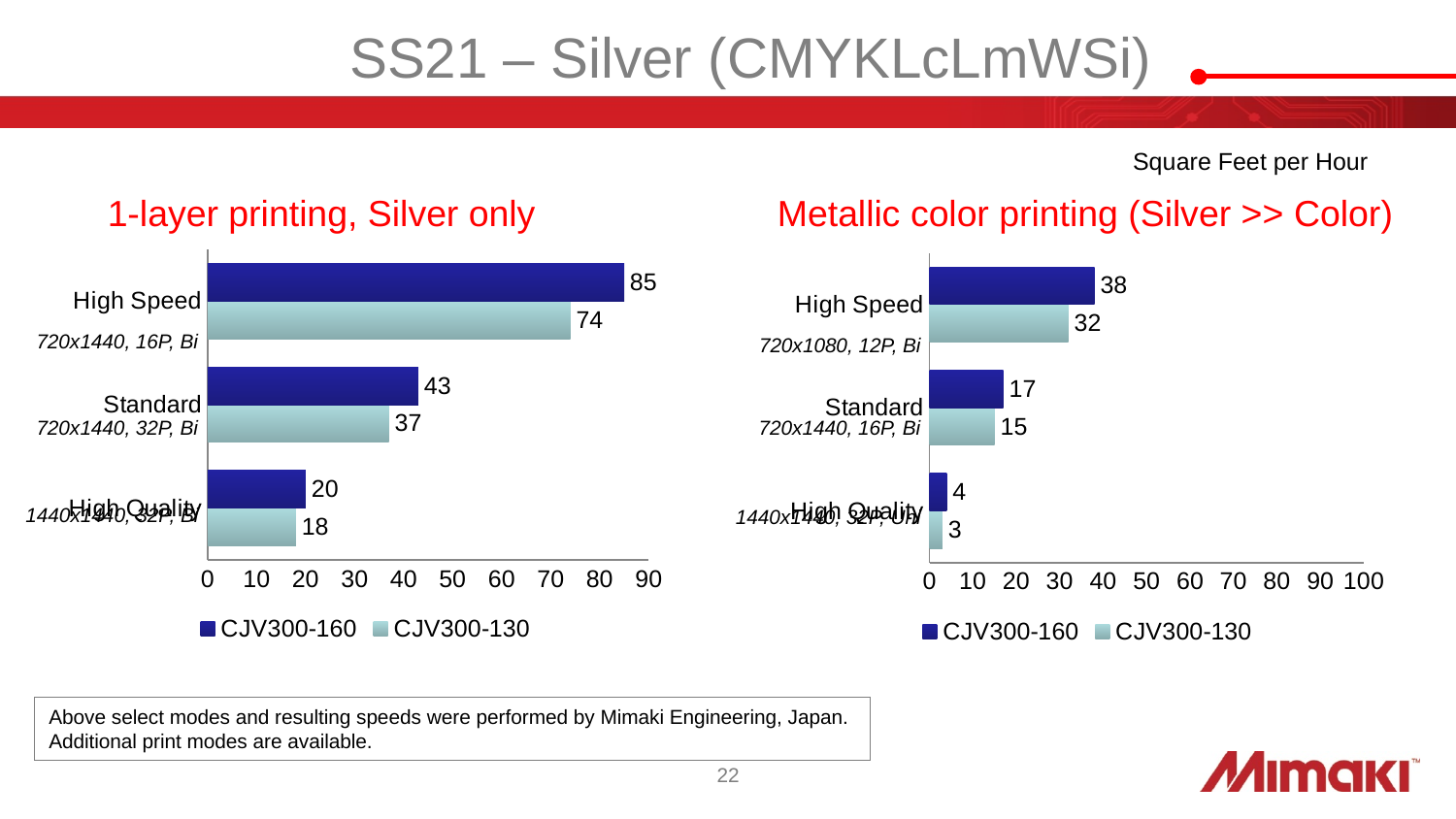
In the 'Metallic color printing (Silver >> Color)' chart, what is the difference between the CJV300-160 and CJV300-130 values in Standard mode? 2 In the '1-layer printing, Silver only' chart, which is larger in Standard mode: CJV300-160 or CJV300-130? CJV300-160 How many series does the legend of the 'Metallic color printing (Silver >> Color)' chart list? 2 In the '1-layer printing, Silver only' chart, what is the value for CJV300-160 in High Speed mode? 85 In the 'Metallic color printing (Silver >> Color)' chart, what is the value for CJV300-130 in High Speed mode? 32 How many print modes are shown in the '1-layer printing, Silver only' chart? 3 What type of chart is the 'Metallic color printing (Silver >> Color)' chart? Bar chart In the '1-layer printing, Silver only' chart, which mode has the highest value for CJV300-160? High Speed In the 'Metallic color printing (Silver >> Color)' chart, which mode has the lowest value for CJV300-130? High Quality In the '1-layer printing, Silver only' chart, what is the value for CJV300-130 in Standard mode? 37 In the 'Metallic color printing (Silver >> Color)' chart, what is the value for CJV300-160 in High Quality mode? 4 In the '1-layer printing, Silver only' chart, what is the difference between the CJV300-160 and CJV300-130 values in High Speed mode? 11